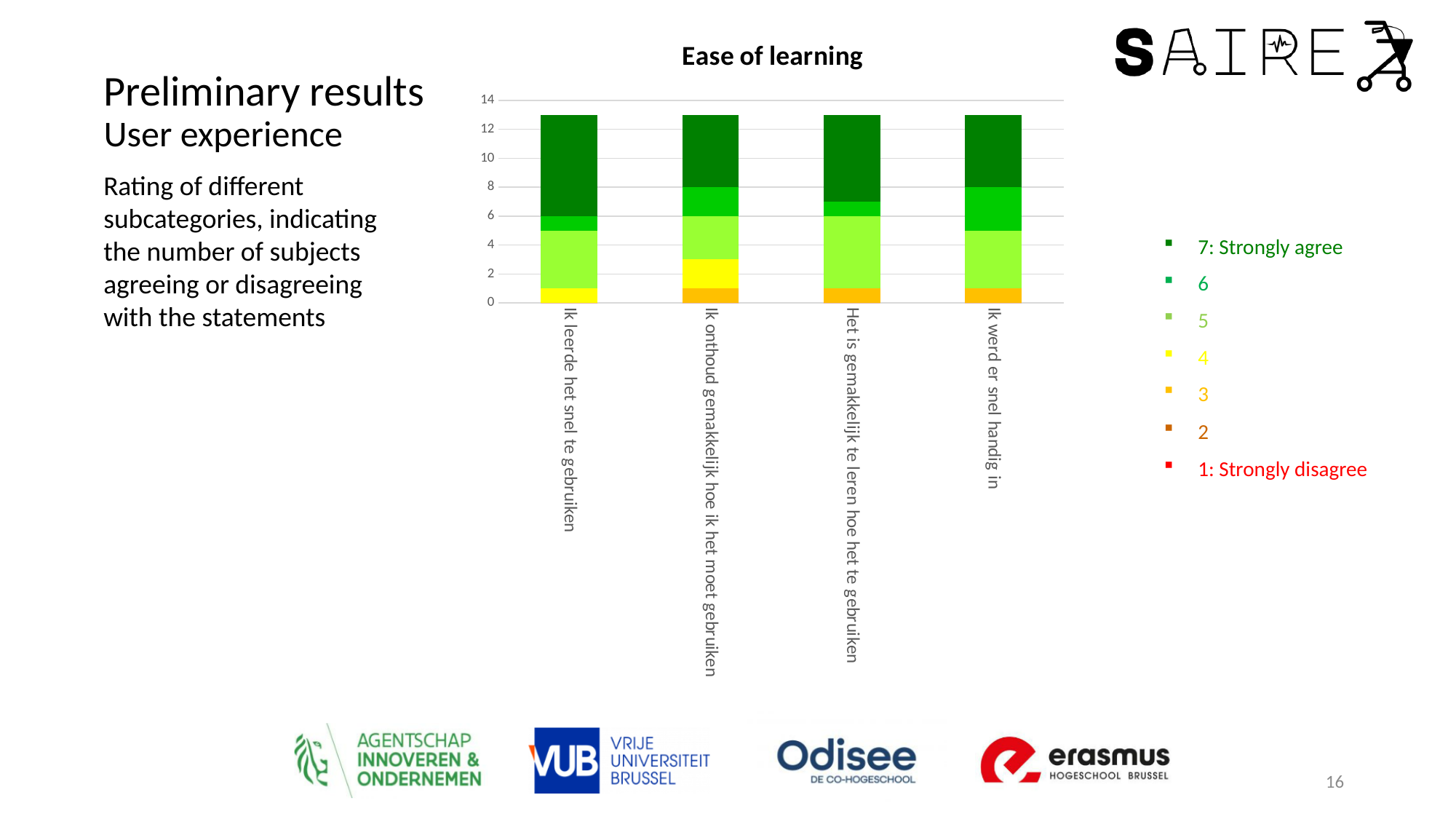
Is the total height of the bar for "Ik leerde het snel te gebruiken" greater or less than 12? greater Is the total height of the bar for "Ik werd er snel handig in" greater or less than 14? less What kind of chart is shown on the slide? Stacked bar chart Is the "5" rating segment larger for "Het is gemakkelijk te leren hoe het te gebruiken" or for "Ik onthoud gemakkelijk hoe ik het moet gebruiken"? Het is gemakkelijk te leren hoe het te gebruiken How many statements (categories) are plotted on the x axis of the chart? 4 What is the title of the chart? Ease of learning What is the top entry in the chart's legend? 7: Strongly agree Is the "7: Strongly agree" segment larger for "Ik leerde het snel te gebruiken" or for "Ik onthoud gemakkelijk hoe ik het moet gebruiken"? Ik leerde het snel te gebruiken Is the total height of the bar for "Ik onthoud gemakkelijk hoe ik het moet gebruiken" greater or less than 12? greater How many of the bars include a yellow "4" rating segment? 2 How many rating levels does the legend of the chart list? 7